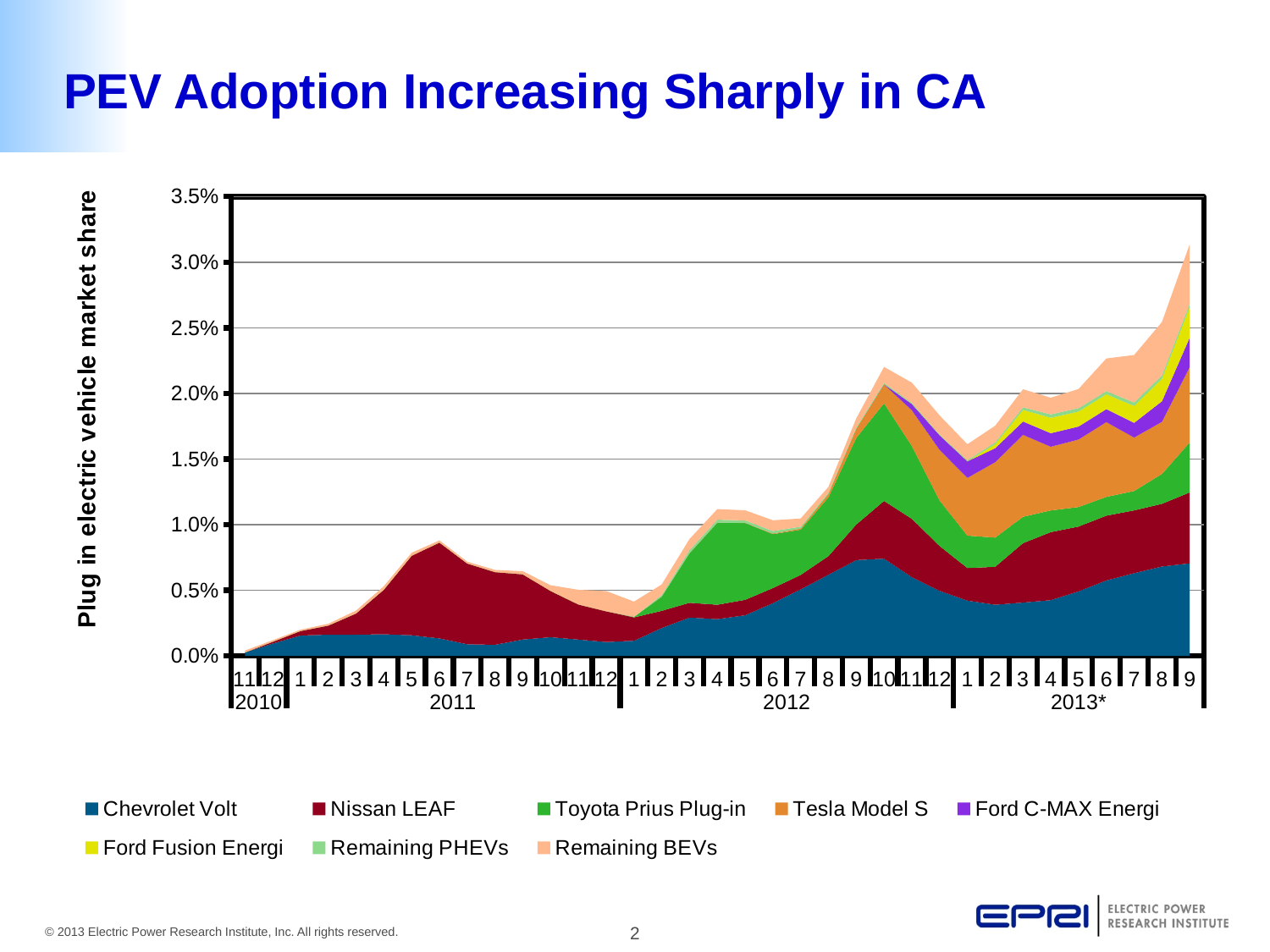
How many series does the legend list? 8 Overall, does the total plug-in market share rise or fall from 2010 to 2013? rise Is the total plug-in market share in month 9 of 2013 greater or less than 2.5%? greater In which month is the total plug-in market share highest? 9 of 2013 Is the total plug-in market share in month 1 of 2012 greater or less than 0.5%? less What is the label on the vertical axis? Plug in electric vehicle market share What is the title of the slide's chart? PEV Adoption Increasing Sharply in CA Is the total plug-in market share in month 6 of 2011 greater or less than 1.0%? less Which is larger, the total market share in month 9 of 2012 or in month 9 of 2013? 9 of 2013 What kind of chart is shown on the slide? Stacked area chart Which series forms the bottom layer of the stacked area? Chevrolet Volt